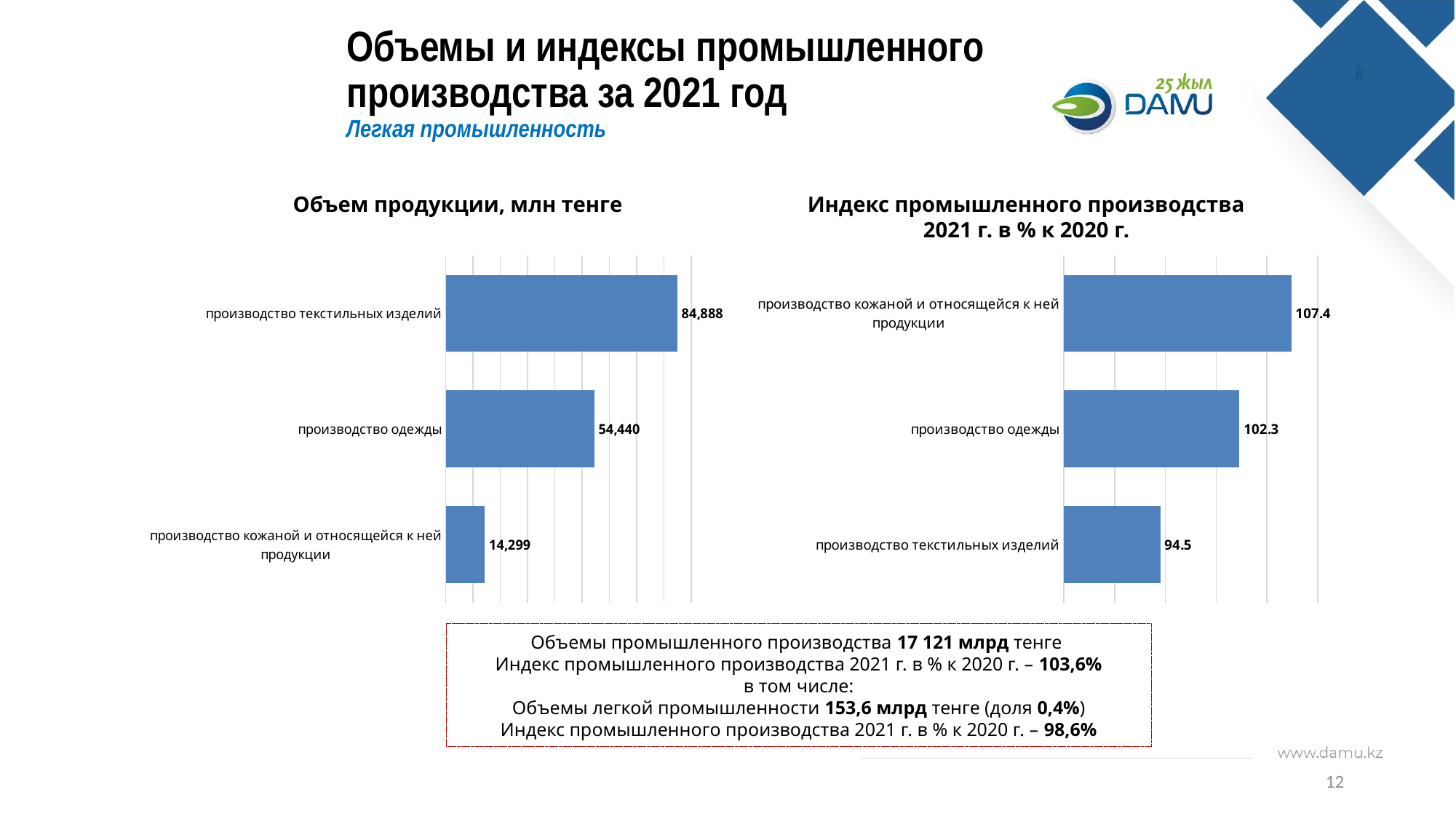
In the chart 'Индекс промышленного производства 2021 г. в % к 2020 г.', which is larger: производство одежды or производство текстильных изделий? производство одежды In the chart 'Индекс промышленного производства 2021 г. в % к 2020 г.', which category has the highest value? производство кожаной и относящейся к ней продукции In the chart 'Объем продукции, млн тенге', how many categories are shown? 3 In the chart 'Объем продукции, млн тенге', which category has the lowest value? производство кожаной и относящейся к ней продукции In the chart 'Объем продукции, млн тенге', what is the value for производство текстильных изделий? 84,888 What type of chart is the chart 'Объем продукции, млн тенге'? bar chart In the chart 'Индекс промышленного производства 2021 г. в % к 2020 г.', what is the value for производство кожаной и относящейся к ней продукции? 107.4 In the chart 'Объем продукции, млн тенге', what is the value for производство одежды? 54,440 In the chart 'Объем продукции, млн тенге', what is the difference between производство текстильных изделий and производство одежды? 30,448 In the chart 'Индекс промышленного производства 2021 г. в % к 2020 г.', what is the difference between производство кожаной и относящейся к ней продукции and производство текстильных изделий? 12.9 In the chart 'Индекс промышленного производства 2021 г. в % к 2020 г.', what is the value for производство текстильных изделий? 94.5 What is the title of the chart on the right side of the slide? Индекс промышленного производства 2021 г. в % к 2020 г.